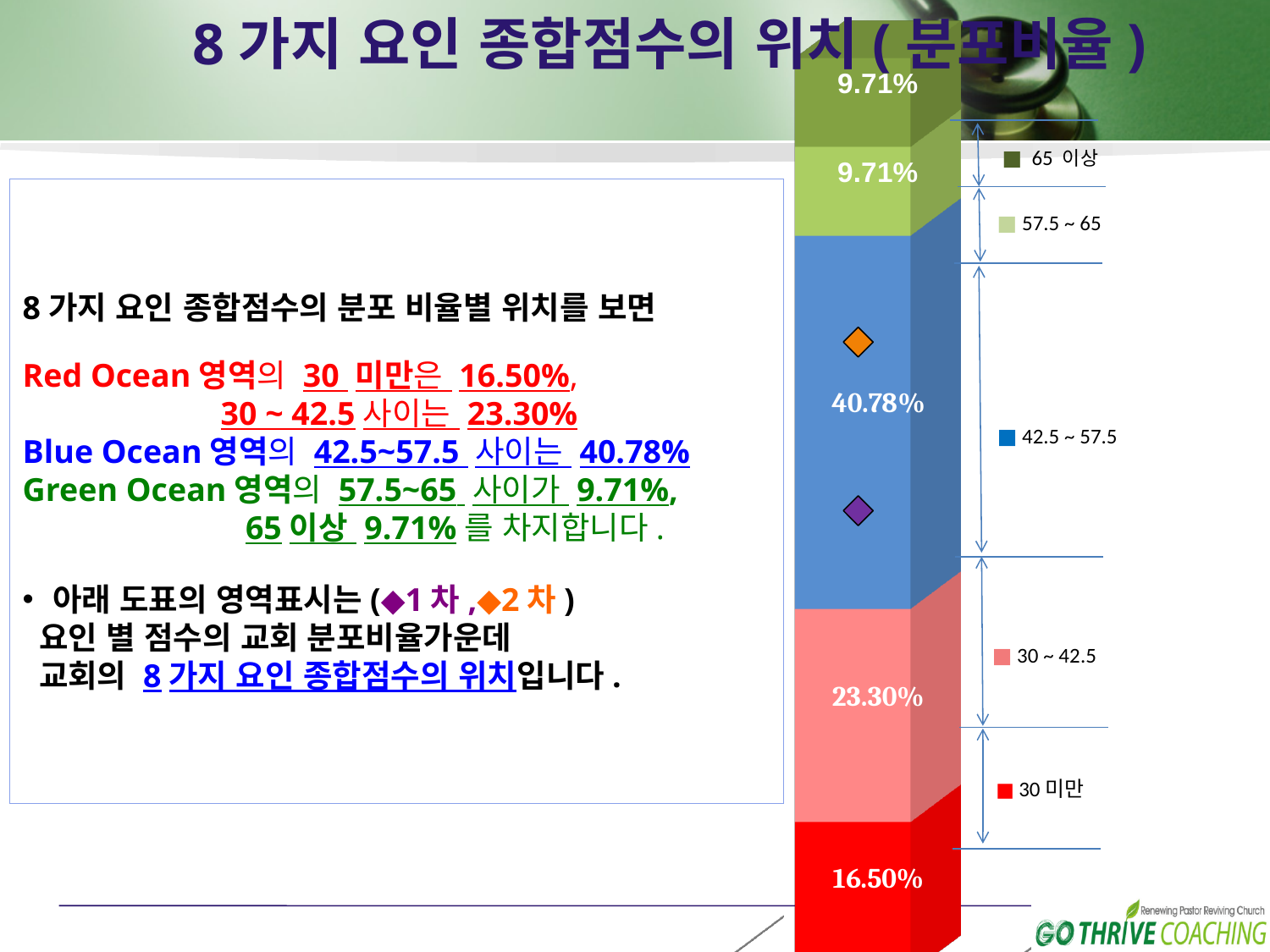
What percentage is shown for the 65 이상 segment of the stacked bar? 9.71% What percentage is shown for the 42.5 ~ 57.5 segment of the stacked bar? 40.78% What kind of chart is shown on the slide? Stacked bar chart How many segments make up the stacked bar? 5 What percentage is shown for the 30 ~ 42.5 segment of the stacked bar? 23.30% Which segment of the stacked bar has the largest percentage? 42.5 ~ 57.5 Which is larger, the 30 미만 segment or the 30 ~ 42.5 segment? 30 ~ 42.5 What is the difference between the 30 ~ 42.5 segment and the 30 미만 segment? 6.80% What is the combined percentage of the 57.5 ~ 65 and 65 이상 segments? 19.42% What is the difference between the 42.5 ~ 57.5 segment and the 30 ~ 42.5 segment? 17.48% How many entries does the chart legend list? 5 What percentage is shown for the 30 미만 segment of the stacked bar? 16.50%